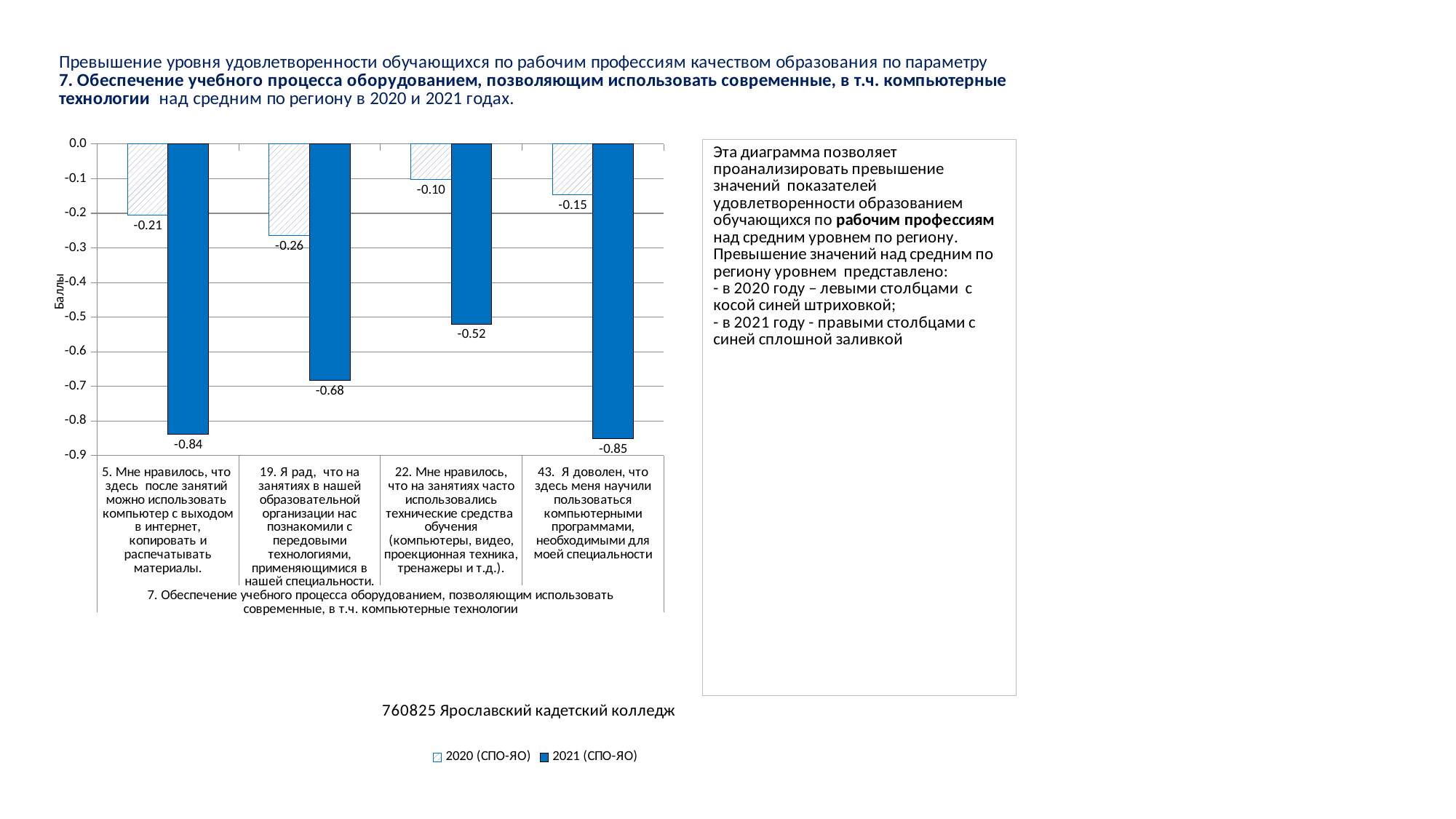
What is the 2020 (СПО-ЯО) value for category 19 ("Я рад, что на занятиях в нашей образовательной организации нас познакомили с передовыми технологиями...")? -0.26 Is the 2021 (СПО-ЯО) value for category 19 greater or less than -0.6? less How many categories are shown on the x axis of the chart? 4 What is the 2020 (СПО-ЯО) value for category 43 ("Я доволен, что здесь меня научили пользоваться компьютерными программами...")? -0.15 Which is larger: the 2020 (СПО-ЯО) value for category 5 or for category 19? Category 5 (-0.21) How many series does the legend list? 2 What is the 2021 (СПО-ЯО) value for category 22 ("Мне нравилось, что на занятиях часто использовались технические средства обучения...")? -0.52 What is the 2021 (СПО-ЯО) value for category 5 ("Мне нравилось, что здесь после занятий можно использовать компьютер с выходом в интернет...")? -0.84 Which category has the highest 2020 (СПО-ЯО) value? 22. Мне нравилось, что на занятиях часто использовались технические средства обучения What is the difference between the 2020 and 2021 values for category 22? 0.42 What type of chart is shown on the slide? Bar chart Which category has the highest 2021 (СПО-ЯО) value? 22. Мне нравилось, что на занятиях часто использовались технические средства обучения